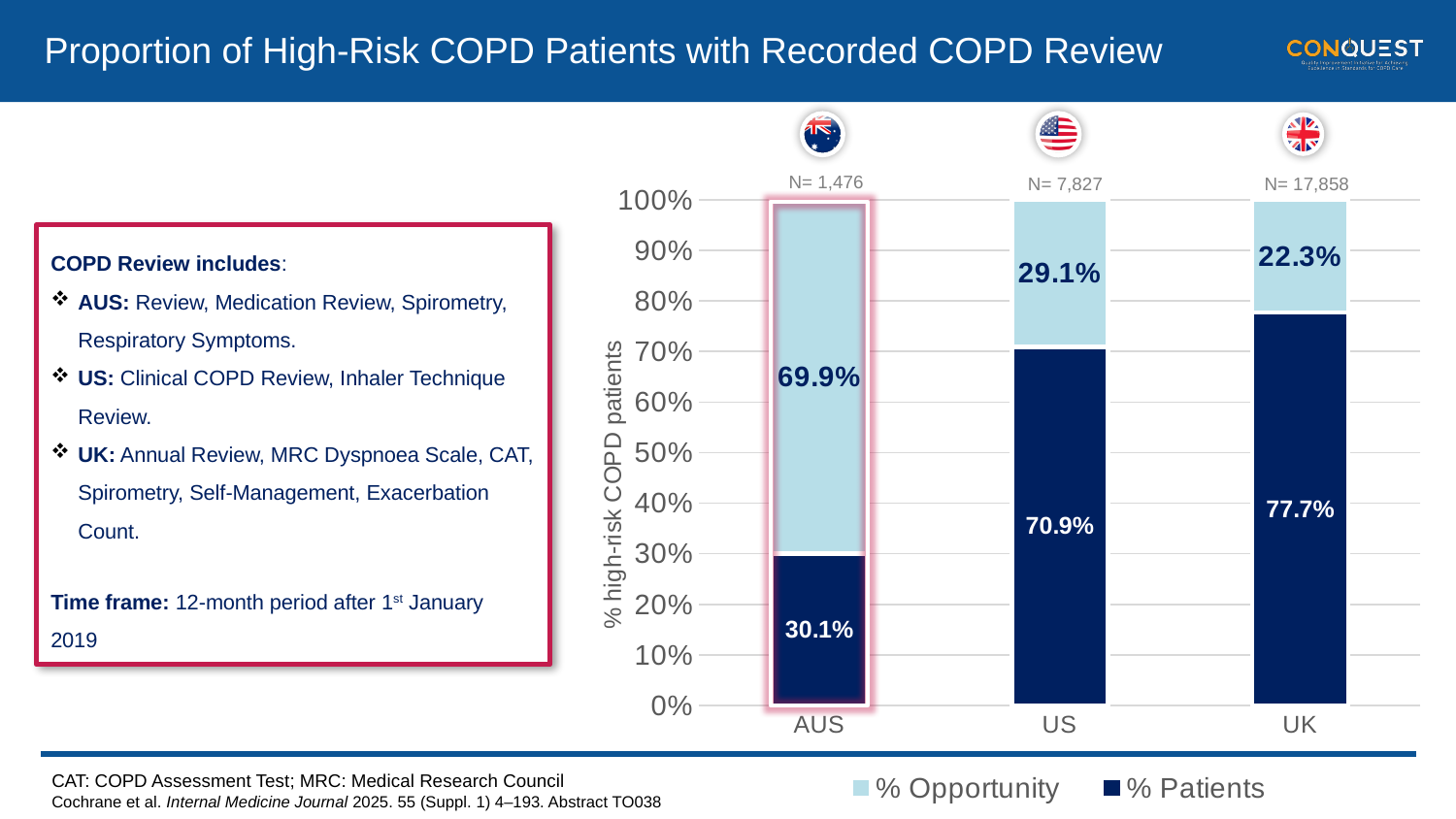
What kind of chart is shown? Stacked bar chart What is the % Opportunity value for the UK? 22.3% Which country has the lowest % Patients value? AUS Which country has the highest % Patients value? UK What is the % Patients value for AUS? 30.1% What is the % Patients value for the US? 70.9% What is the total of the stacked bar for the US? 100% How many series does the legend list? 2 What is the N value shown above the UK bar? N= 17,858 Which is larger, the % Opportunity value for AUS or for the US? AUS How many countries are shown on the x axis? 3 What is the difference between the % Patients values for the UK and the US? 6.8%